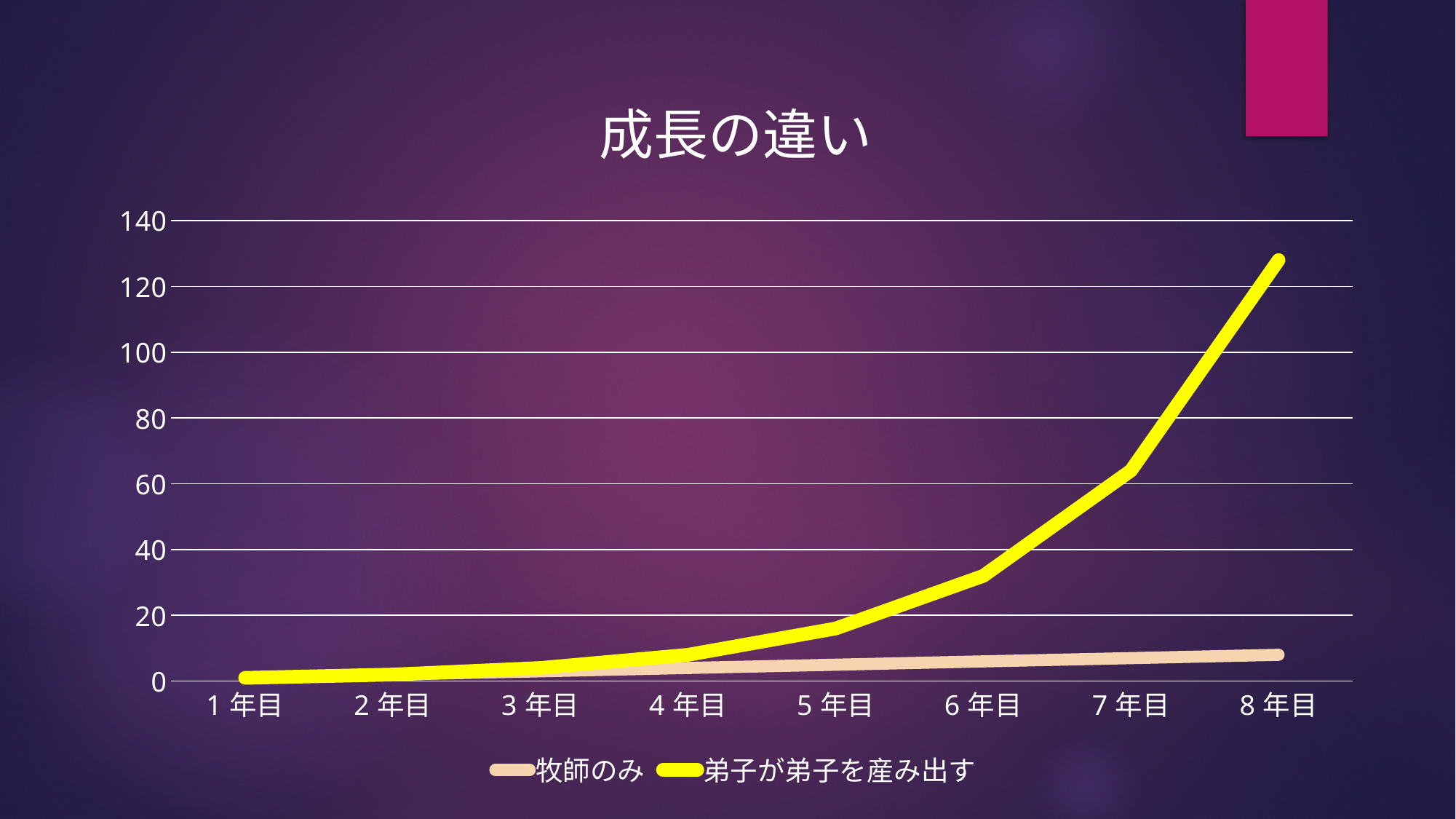
Is the value for 牧師のみ at 8年目 greater or less than 20? less How many series does the legend list? 2 What kind of chart is shown on the slide? line chart How many categories are shown on the x axis? 8 Do the values for 弟子が弟子を産み出す rise or fall from 1年目 to 8年目? rise Which series is drawn in yellow? 弟子が弟子を産み出す Is the value for 弟子が弟子を産み出す at 6年目 greater or less than 40? less Is the value for 弟子が弟子を産み出す at 8年目 greater or less than 120? greater In which year does 弟子が弟子を産み出す reach its highest value? 8年目 What is the title of the chart? 成長の違い At 8年目, which series has the larger value, 牧師のみ or 弟子が弟子を産み出す? 弟子が弟子を産み出す